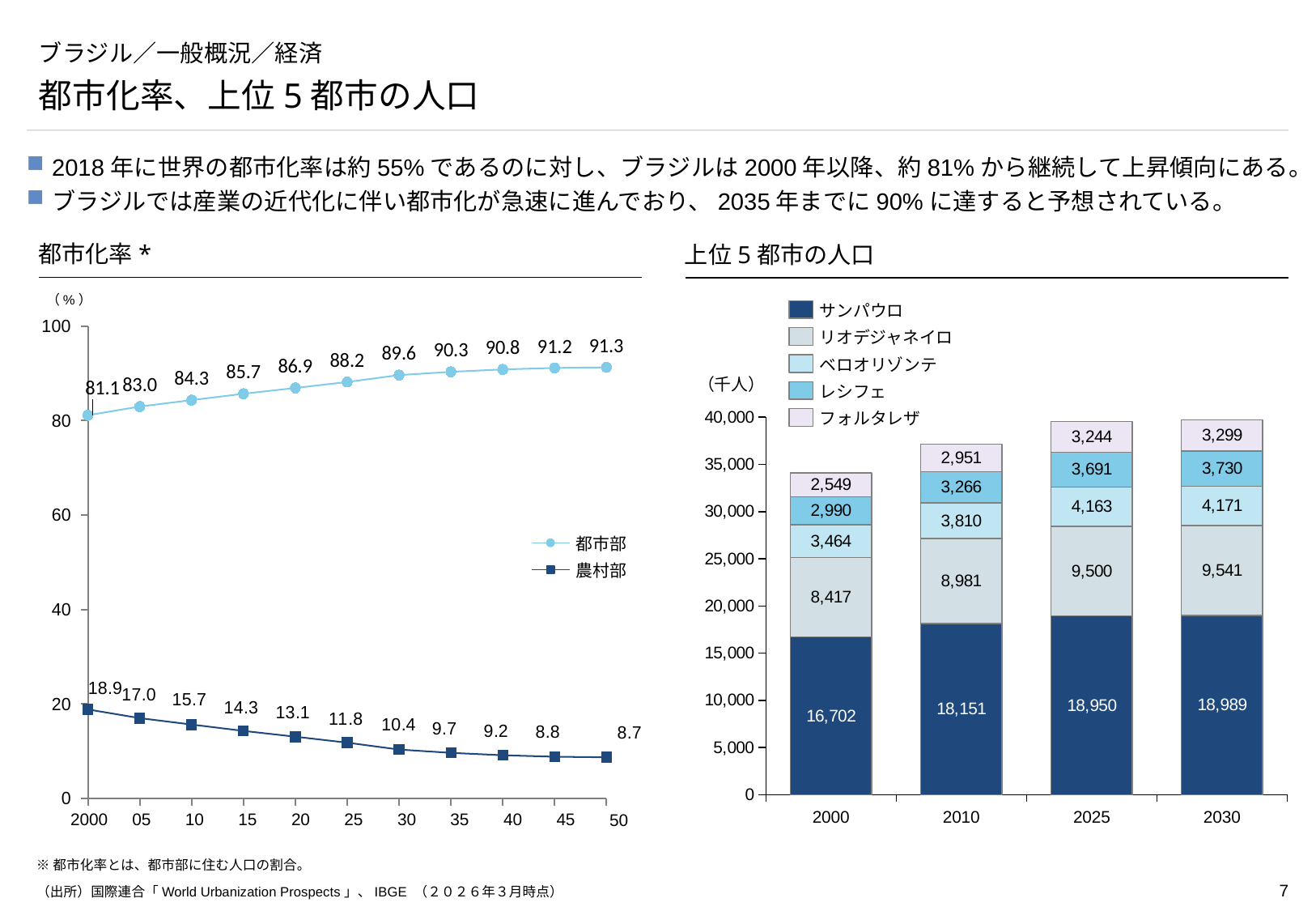
In the 上位5都市の人口 chart, what is the value for フォルタレザ in 2010? 2,951 In the 都市化率 chart, what is the value for 農村部 in 2050? 8.7 In the 上位5都市の人口 chart, how many years are shown on the x axis? 4 In the 都市化率 chart, what is the value for 都市部 in 2000? 81.1 In the 都市化率 chart, does the 農村部 series rise or fall from 2000 to 2050? fall In the 都市化率 chart, what is the difference between the 都市部 value in 2050 and the 都市部 value in 2000? 10.2 In the 都市化率 chart, how many series does the legend list? 2 In the 上位5都市の人口 chart, what is the value for サンパウロ in 2025? 18,950 What kind of chart is the 都市化率 chart? line chart In the 上位5都市の人口 chart, which is larger in 2030: リオデジャネイロ or ベロオリゾンテ? リオデジャネイロ In the 上位5都市の人口 chart, what is the total of the stacked bar for 2000? 34,122 In the 上位5都市の人口 chart, how many series does the legend list? 5